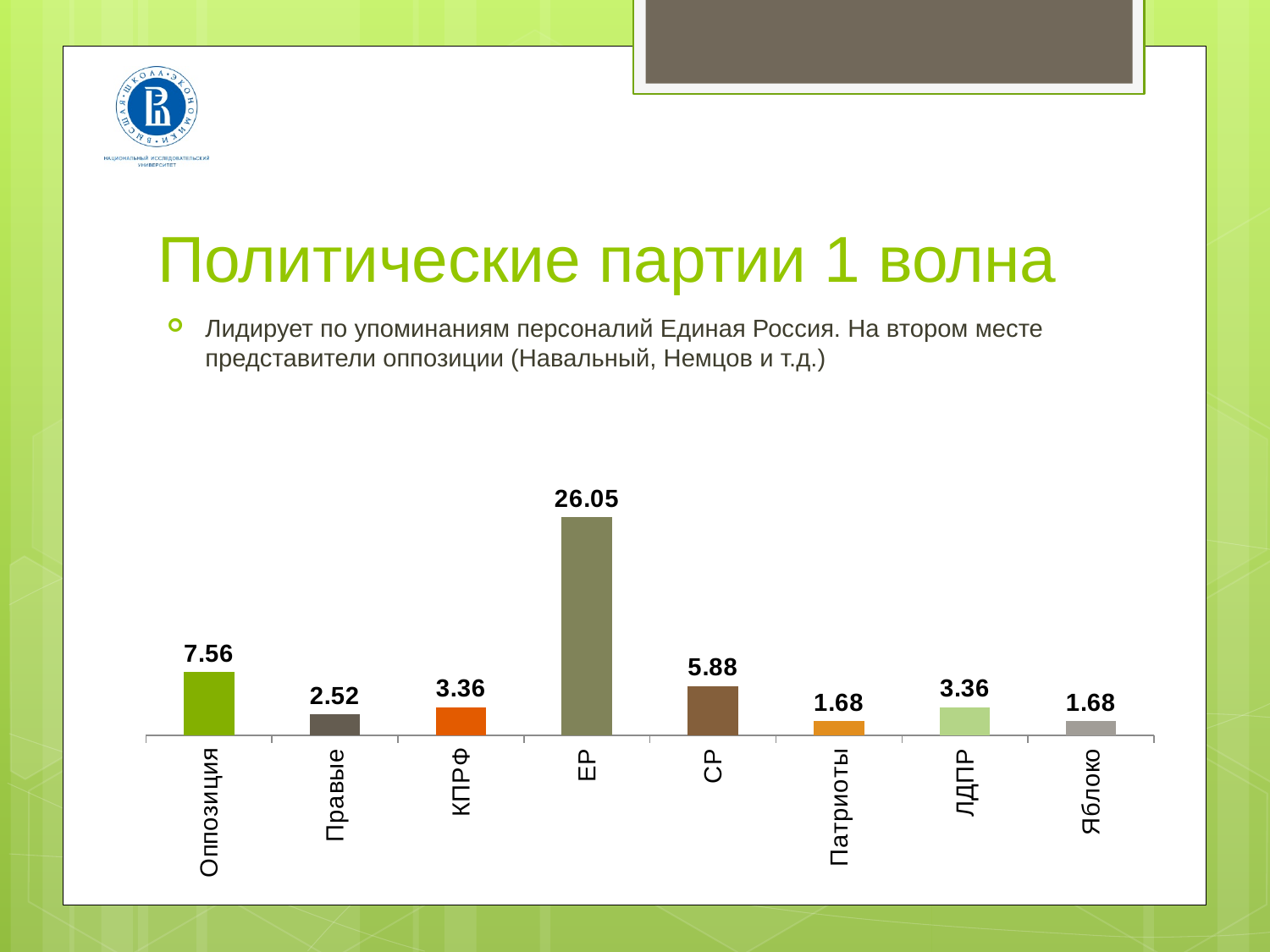
What is the value for СР? 5.88 What is the difference between the values for СР and КПРФ? 2.52 What is the difference between the values for ЕР and Оппозиция? 18.49 What is the value for Оппозиция? 7.56 Which is larger, the value for Оппозиция or the value for СР? Оппозиция What is the title of the slide containing the chart? Политические партии 1 волна What is the value for ЕР? 26.05 How many categories are shown on the x axis? 8 Which category has the highest value? ЕР What kind of chart is shown on the slide? bar chart Which categories share the lowest value of 1.68? Патриоты and Яблоко What is the value for Правые? 2.52